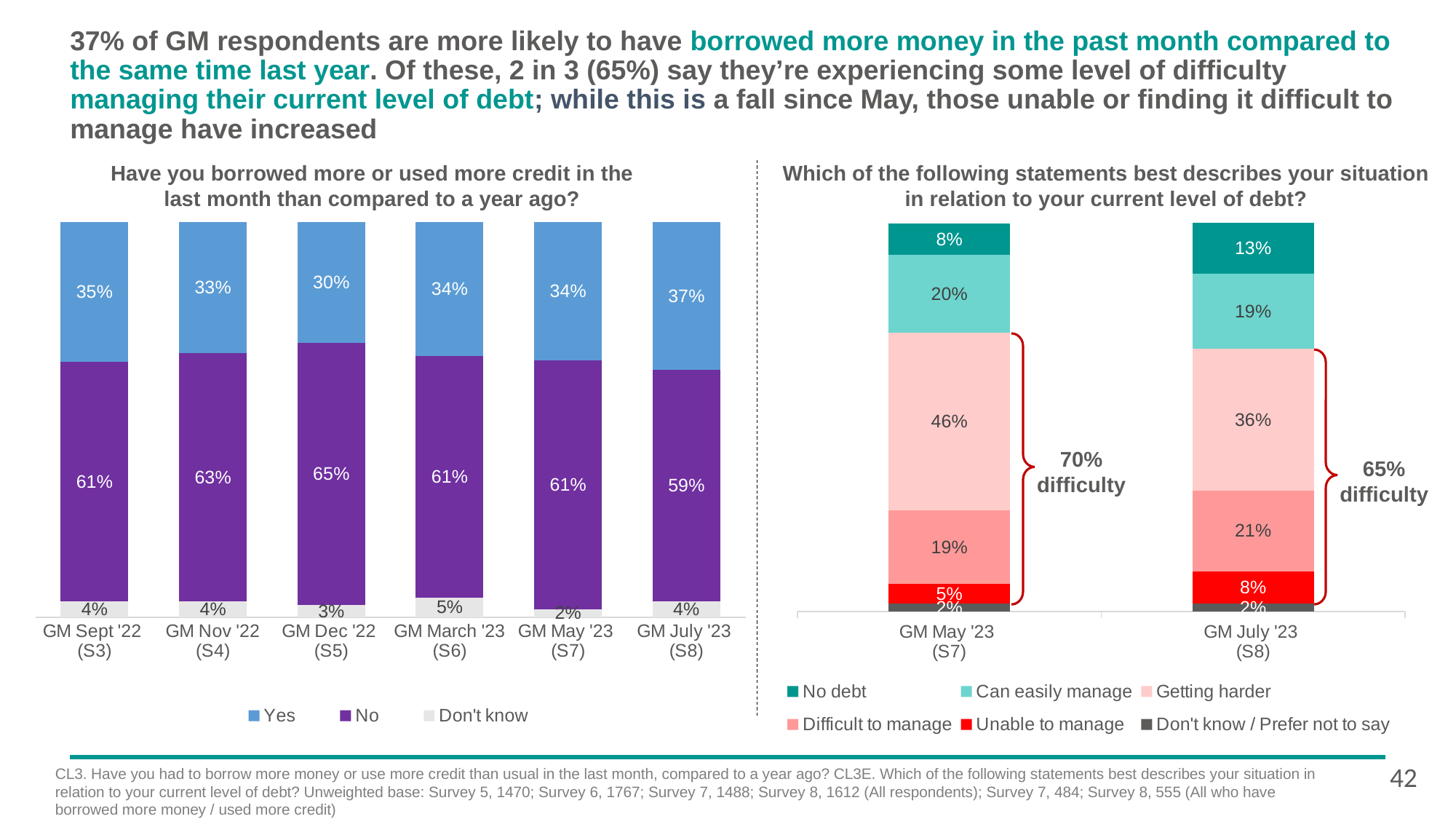
In the right chart (current level of debt), is the No debt percentage larger in GM May '23 (S7) or GM July '23 (S8)? GM July '23 (S8) In the right chart (current level of debt), what percentage said Getting harder in GM May '23 (S7)? 46% In the right chart (current level of debt), what percentage said Unable to manage in GM July '23 (S8)? 8% In the left chart (borrowed more or used more credit), what percentage answered No in GM Dec '22 (S5)? 65% In the right chart (current level of debt), what is the difference between the Difficult to manage percentage in GM July '23 (S8) and GM May '23 (S7)? 2% What type of chart is the left chart (borrowed more or used more credit)? Stacked bar chart In the left chart (borrowed more or used more credit), which survey wave has the highest Don't know percentage? GM March '23 (S6) In the left chart (borrowed more or used more credit), which survey wave has the lowest Yes percentage? GM Dec '22 (S5) In the right chart (current level of debt), how many series does the legend list? 6 In the left chart (borrowed more or used more credit), what is the difference between the Yes percentage in GM July '23 (S8) and GM May '23 (S7)? 3% In the left chart (borrowed more or used more credit), how many survey waves are shown on the x axis? 6 In the left chart (borrowed more or used more credit), what percentage answered Yes in GM July '23 (S8)? 37%